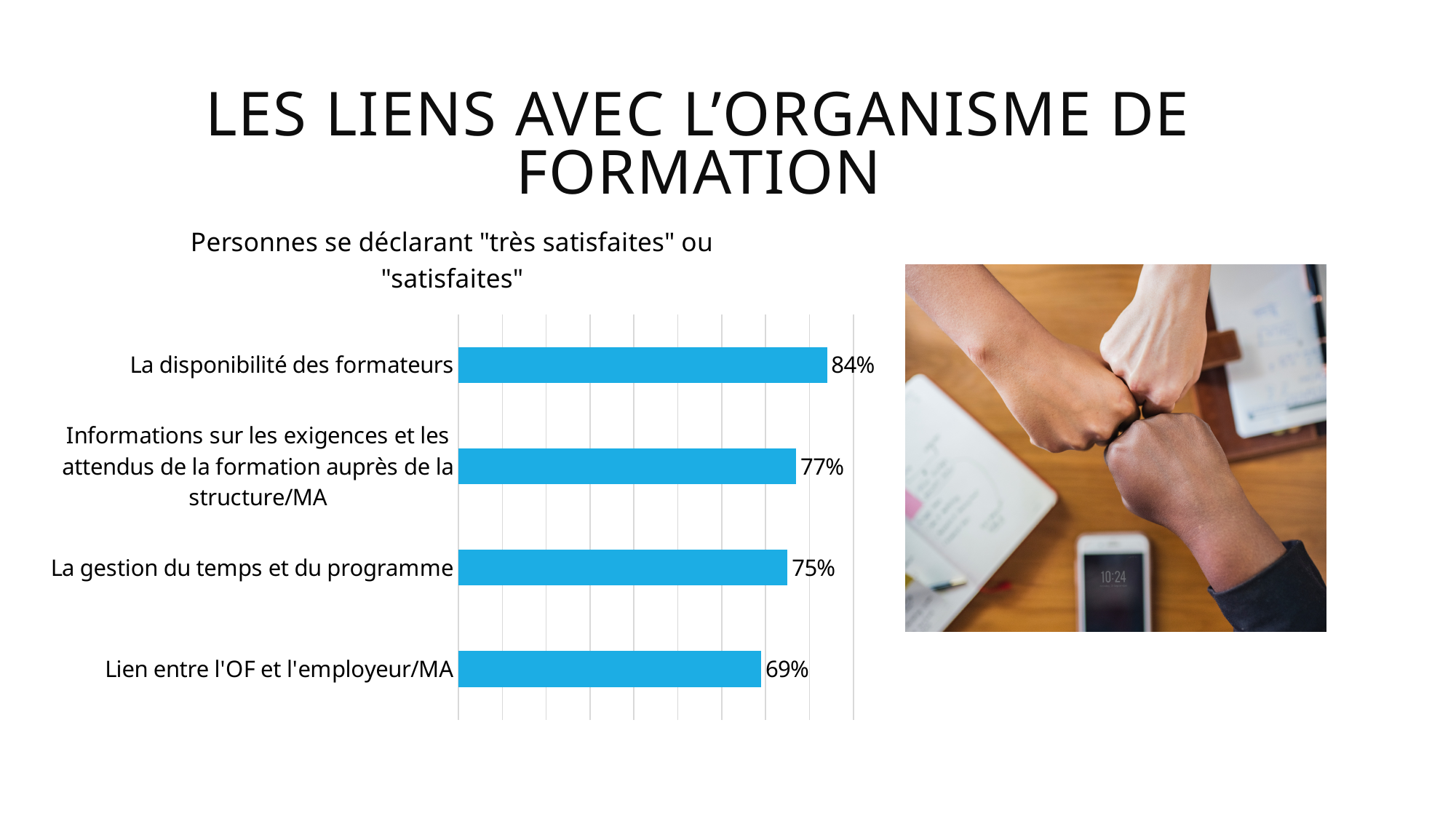
Which is larger: the value for "La gestion du temps et du programme" or the value for "Lien entre l'OF et l'employeur/MA"? La gestion du temps et du programme What is the value for "La disponibilité des formateurs"? 84% Which category has the lowest value? Lien entre l'OF et l'employeur/MA What is the value for "La gestion du temps et du programme"? 75% What is the value for "Informations sur les exigences et les attendus de la formation auprès de la structure/MA"? 77% What is the difference between the values for "Informations sur les exigences et les attendus de la formation auprès de la structure/MA" and "La gestion du temps et du programme"? 2% What is the value for "Lien entre l'OF et l'employeur/MA"? 69% What is the title of the chart? Personnes se déclarant "très satisfaites" ou "satisfaites" Which category has the highest value? La disponibilité des formateurs What is the difference between the values for "La disponibilité des formateurs" and "Lien entre l'OF et l'employeur/MA"? 15% How many categories are shown in the chart? 4 What kind of chart is shown on the slide? Bar chart